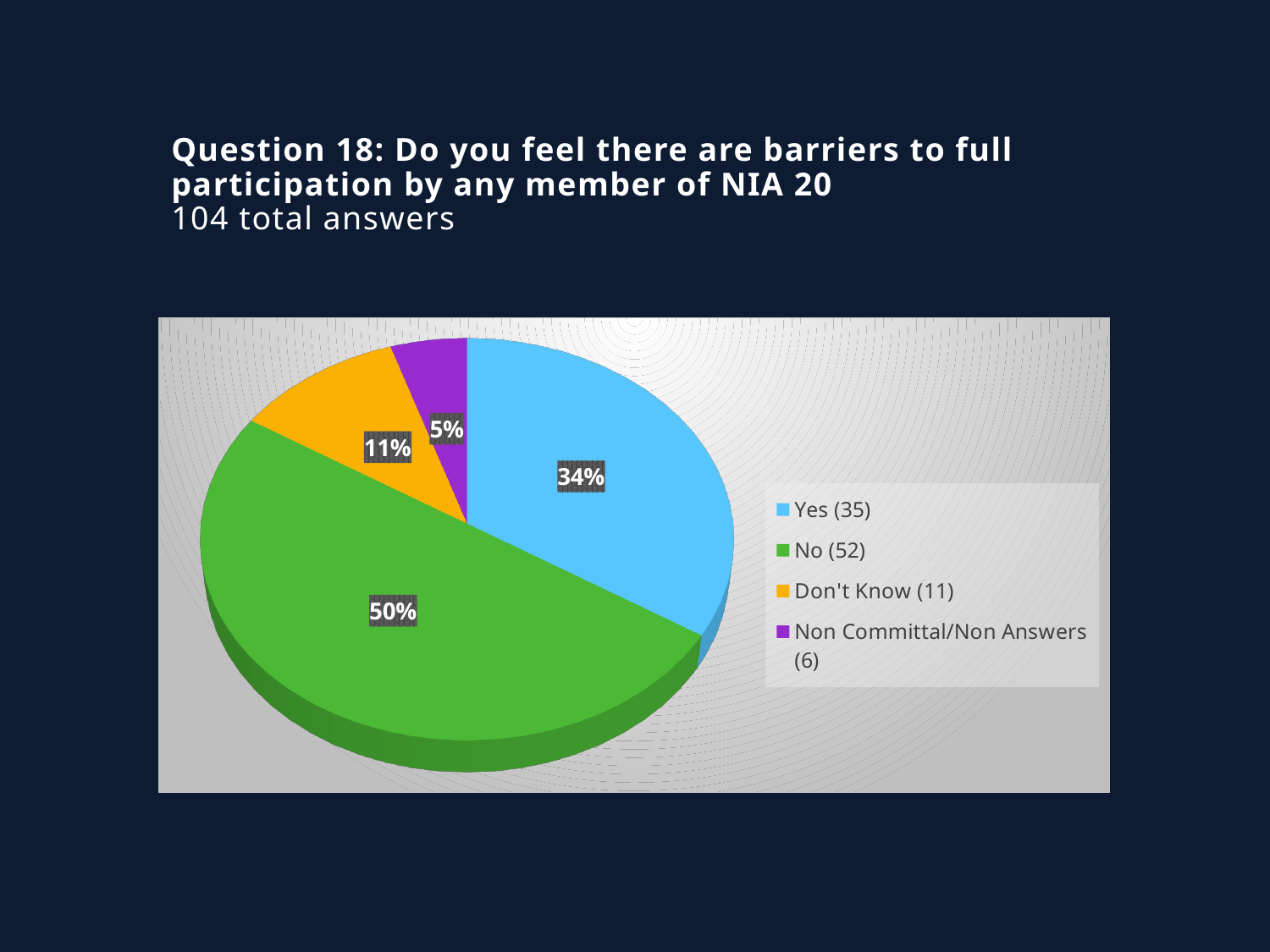
How many answers does the legend show for "No"? 52 Which category has the smallest slice of the pie? Non Committal/Non Answers Which slice is larger, "Don't Know" or "Non Committal/Non Answers"? Don't Know What percentage of the pie does the "Yes" slice represent? 34% Which category has the largest slice of the pie? No What colour is the "Yes" slice in the pie chart? Light blue What kind of chart is shown on the slide? Pie chart What is the difference in percentage points between the "No" slice and the "Yes" slice? 16 percentage points What percentage of the pie does the "No" slice represent? 50% What percentage of the pie does the "Don't Know" slice represent? 11% How many categories does the pie chart show? 4